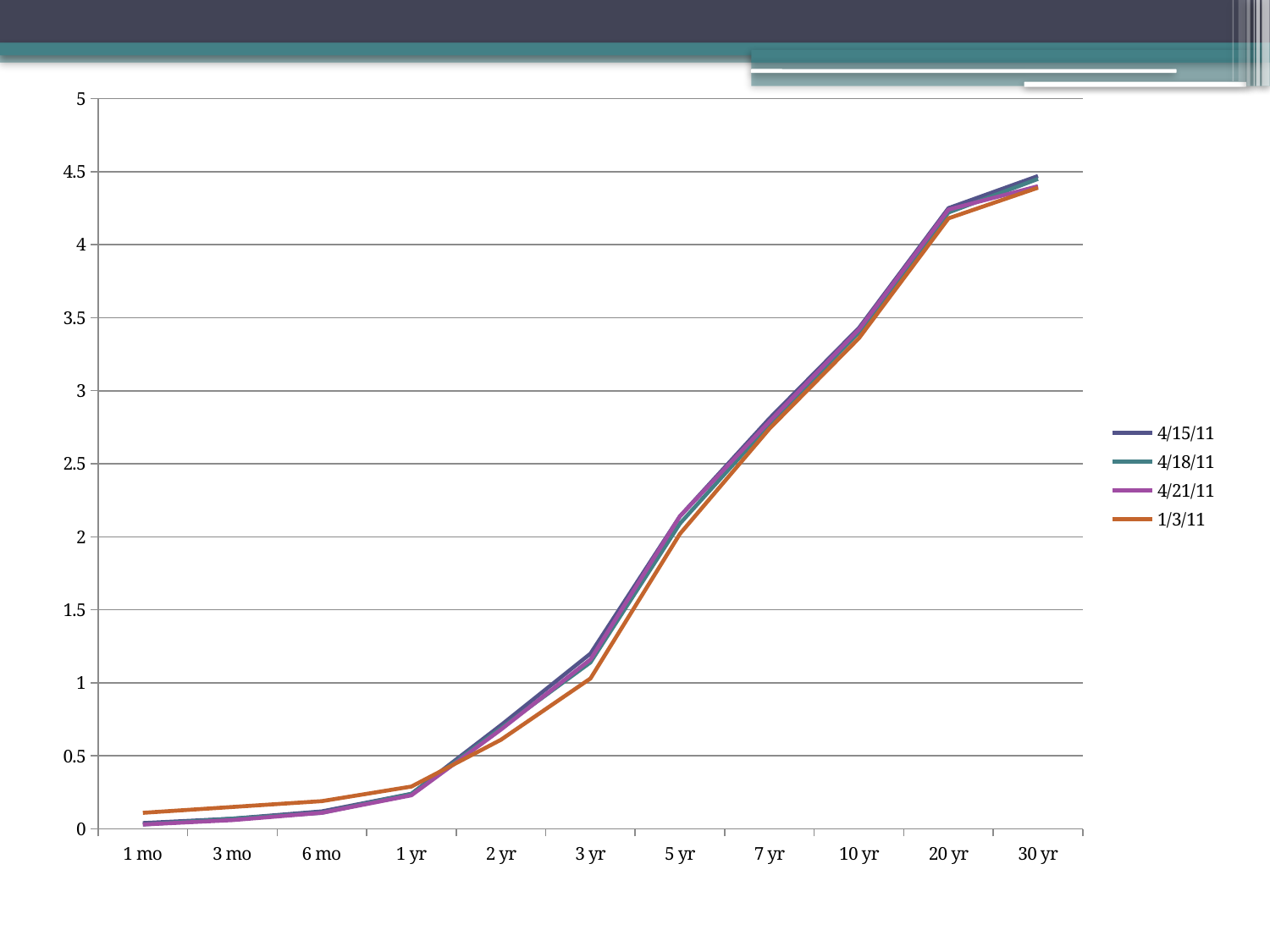
Do the values for the 4/15/11 series rise or fall as you move from 1 mo to 30 yr along the x axis? rise What kind of chart is shown on the slide? line chart Is the value for the 1/3/11 series at 30 yr greater or less than 4? greater At which x-axis category does the 4/21/11 series have its lowest value? 1 mo How many categories are shown on the x axis? 11 At 3 yr, which series has the larger value: 4/15/11 or 1/3/11? 4/15/11 At 1 mo, which series has the larger value: 1/3/11 or 4/15/11? 1/3/11 Is the value for the 4/15/11 series at 10 yr greater or less than 3? greater At which x-axis category does the 1/3/11 series reach its highest value? 30 yr Is the value for the 1/3/11 series at 1 yr greater or less than 0.5? less How many series does the legend list? 4 Which series is drawn in orange according to the legend? 1/3/11